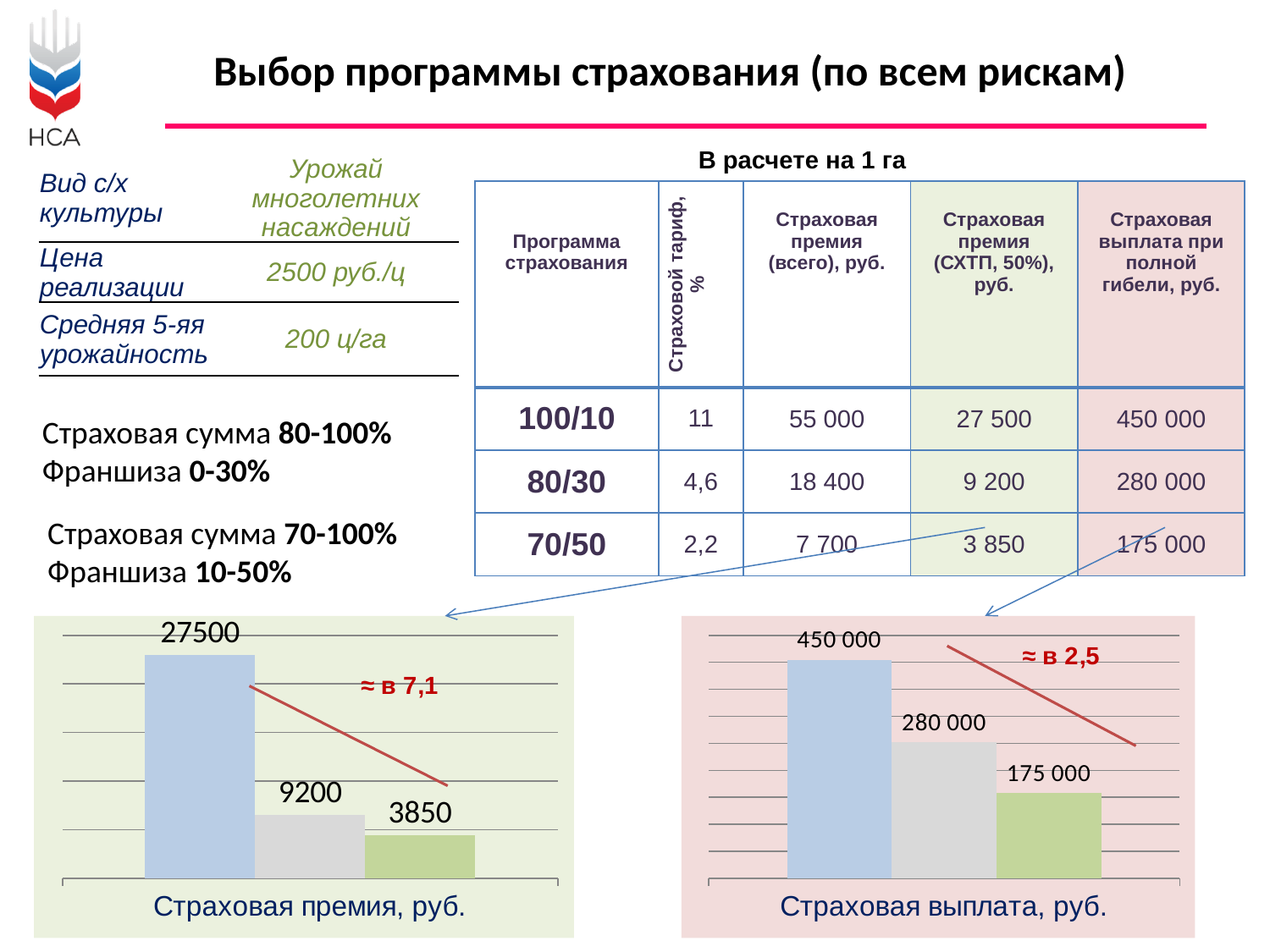
What ratio is written in red on the left chart "Страховая премия, руб."? ≈ в 7,1 In the right chart "Страховая выплата, руб.", what is the value of the middle (grey) bar? 280 000 In the right chart "Страховая выплата, руб.", what is the difference between the first bar (450 000) and the middle bar (280 000)? 170 000 In the left chart "Страховая премия, руб.", what is the difference between the first bar (27500) and the last bar (3850)? 23650 In the right chart "Страховая выплата, руб.", do the bar values rise or fall from left to right? fall In the left chart "Страховая премия, руб.", what is the value of the middle (grey) bar? 9200 In the left chart "Страховая премия, руб.", what is the value of the tallest (blue) bar? 27500 In the left chart "Страховая премия, руб.", what is the value of the smallest (green) bar? 3850 How many bars are plotted in the left chart "Страховая премия, руб."? 3 In the right chart "Страховая выплата, руб.", what is the value of the first (blue) bar? 450 000 In the right chart "Страховая выплата, руб.", what is the value of the last (green) bar? 175 000 What kind of chart is the left chart titled "Страховая премия, руб."? bar chart